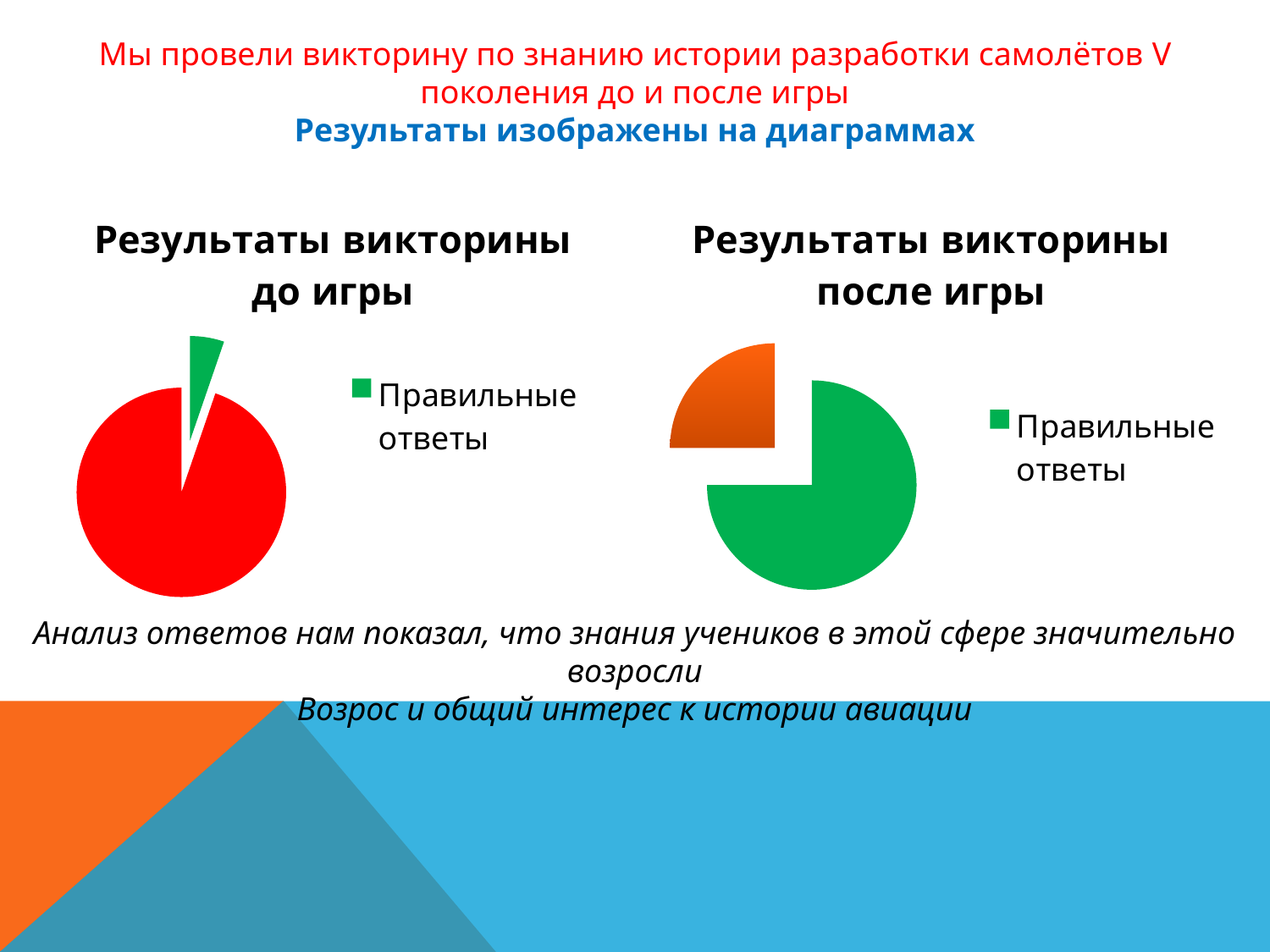
How many slices does the "Результаты викторины после игры" pie chart have? 2 How many entries does the legend of the "Результаты викторины после игры" chart list? 1 In the "Результаты викторины после игры" chart, is the "Правильные ответы" slice the largest or the smallest slice? the largest How many entries does the legend of the "Результаты викторины до игры" chart list? 1 What kind of chart is the "Результаты викторины после игры" chart? pie chart In the "Результаты викторины до игры" chart, which slice is larger, the green one or the red one? the red one In the "Результаты викторины до игры" chart, is the "Правильные ответы" slice the largest or the smallest slice? the smallest How many slices does the "Результаты викторины до игры" pie chart have? 2 In the "Результаты викторины после игры" chart, which slice is larger, the green one or the orange one? the green one What is the legend entry shown next to the "Результаты викторины после игры" chart? Правильные ответы What is the title of the pie chart on the left side of the slide? Результаты викторины до игры What kind of chart is the "Результаты викторины до игры" chart? pie chart